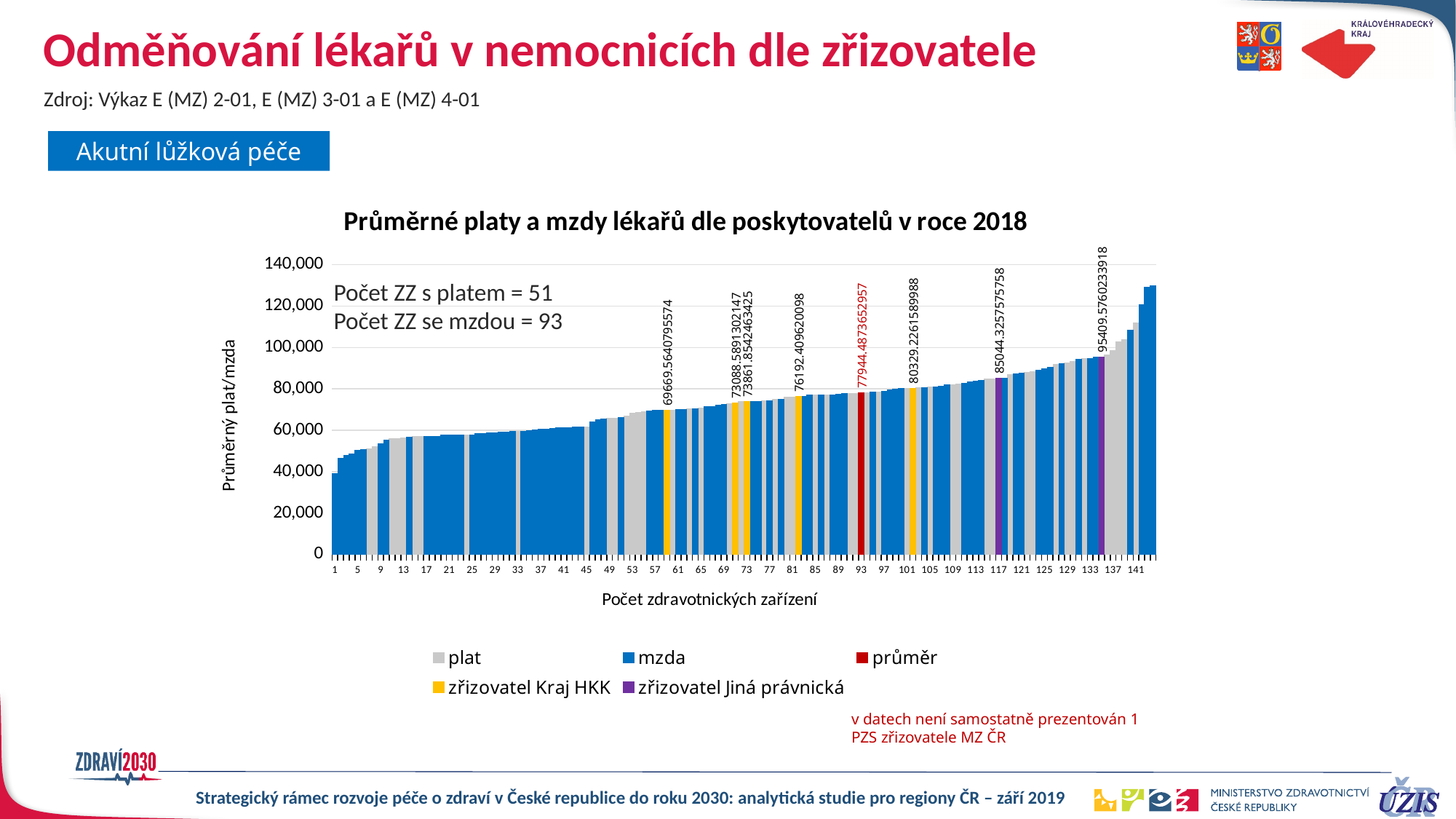
What is the title of the chart? Průměrné platy a mzdy lékařů dle poskytovatelů v roce 2018 Do the bar values rise or fall from left to right along the x axis? rise What kind of chart is shown on the slide? bar chart Which of the printed data labels on the chart shows the lowest value? 69669.5640795574 What is the value printed on the first yellow 'zřizovatel Kraj HKK' bar (around position 58)? 69669.5640795574 What is the value printed on the purple bar near position 117? 85044.3257575758 Which of the printed data labels on the chart shows the highest value? 95409.5760233918 How many entries does the legend of the chart list? 5 What is the value printed on the red 'průměr' bar? 77944.4873652957 What is the value printed on the purple 'zřizovatel Jiná právnická' bar near position 135? 95409.5760233918 Is the value of the red 'průměr' bar greater or less than 80,000? less Is the value of the tallest bar at the right end of the chart greater or less than 120,000? greater